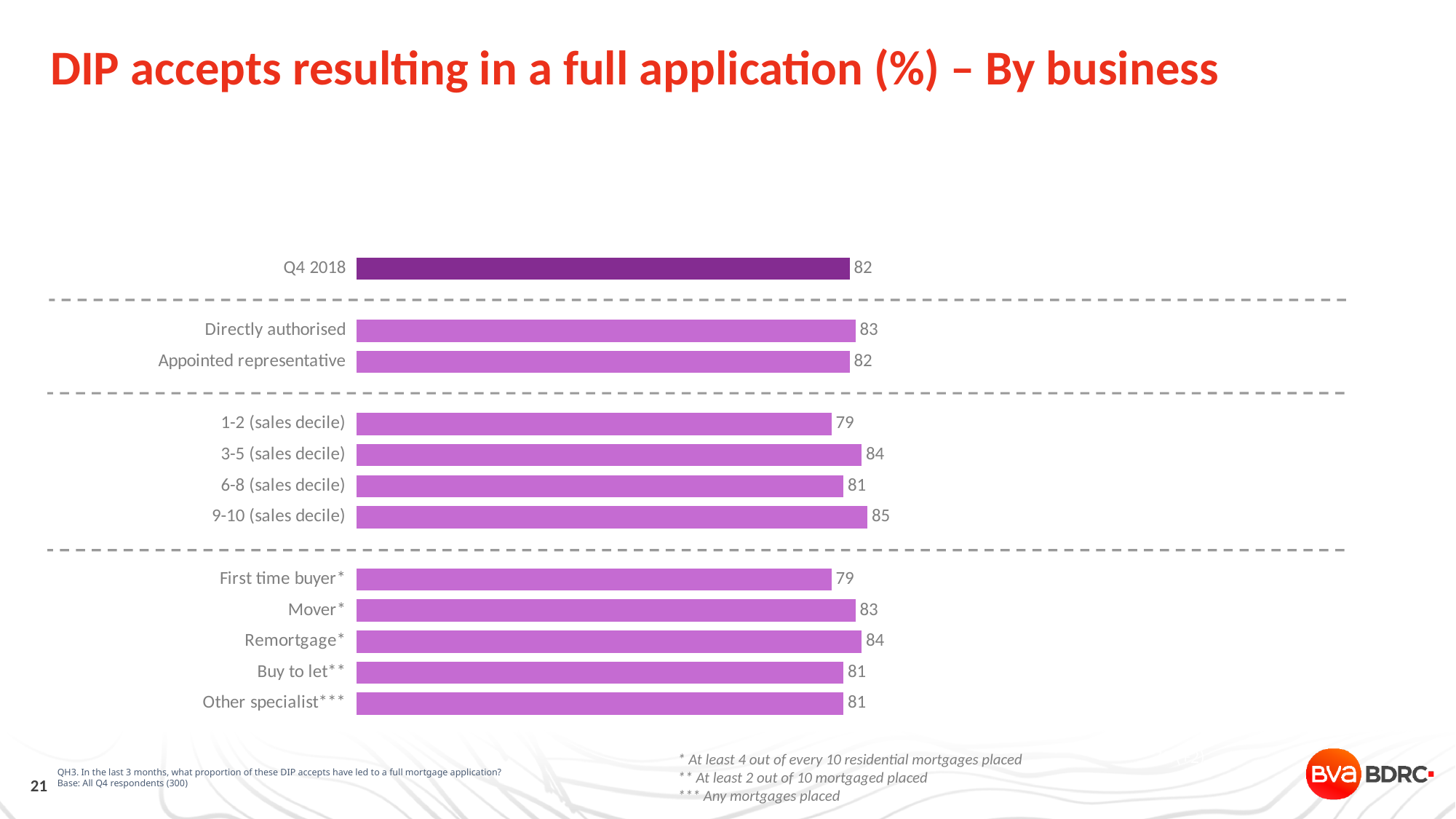
What is the title of the slide? DIP accepts resulting in a full application (%) – By business Which is larger, the value for Remortgage or the value for Buy to let? Remortgage What is the value for 9-10 (sales decile)? 85 How many categories are plotted in the chart? 13 What is the value for Other specialist? 81 What kind of chart is shown on the slide? Bar chart What is the value for First time buyer? 79 What is the value for Directly authorised? 83 Which category has the highest value? 9-10 (sales decile) What is the difference between the values for Directly authorised and Appointed representative? 1 What is the value for Q4 2018? 82 What is the difference between the values for 9-10 (sales decile) and 1-2 (sales decile)? 6